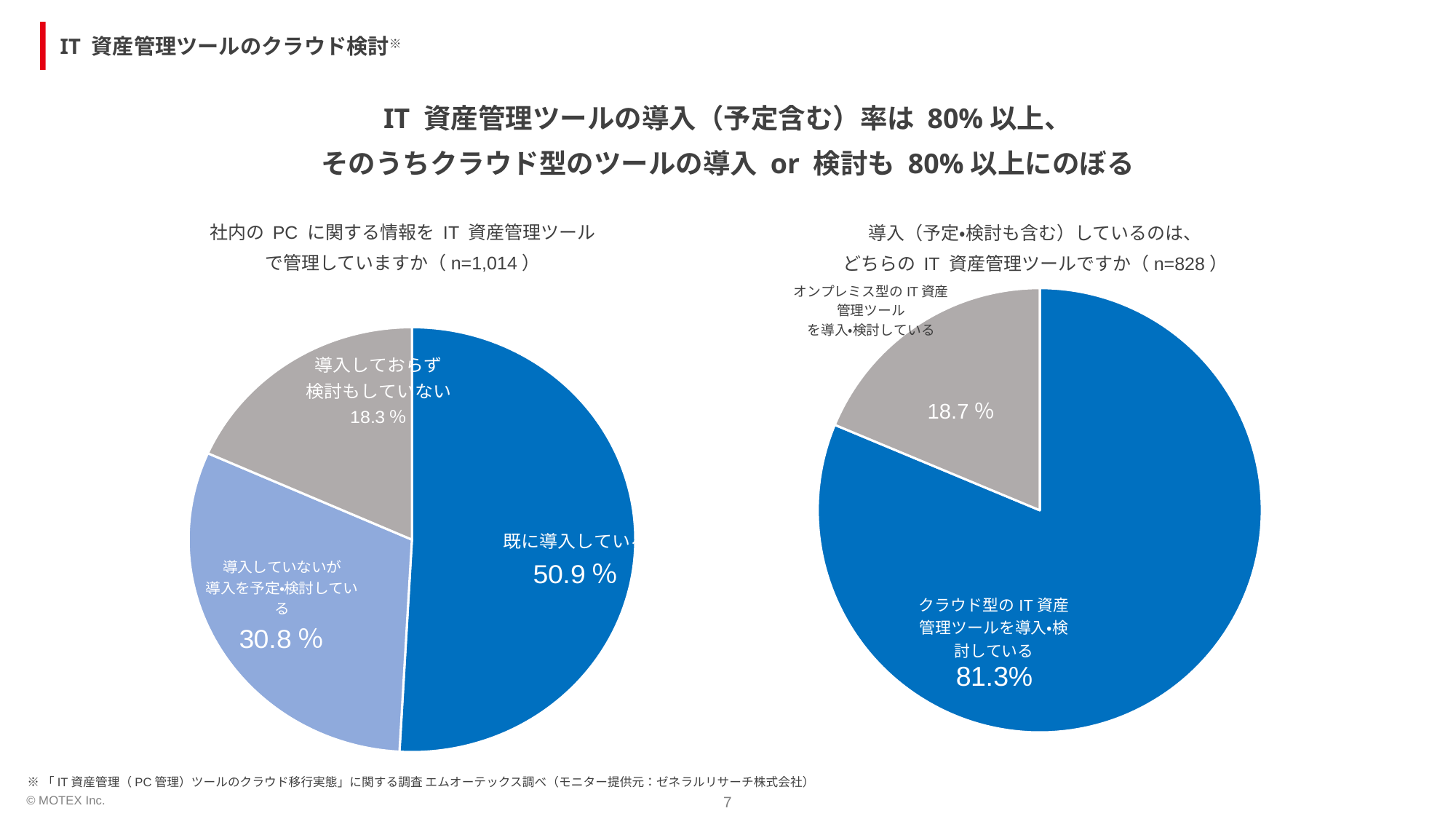
左の円グラフで、「既に導入している」と「導入していないが導入を予定・検討している」の割合の差はいくつですか？ 20.1% 右の円グラフには項目がいくつありますか？ 2 左の円グラフ（社内のPCに関する情報をIT資産管理ツールで管理していますか）で、「既に導入している」の割合はいくつですか？ 50.9% 右の円グラフで、「オンプレミス型のIT資産管理ツールを導入・検討している」の割合はいくつですか？ 18.7% 左の円グラフには項目がいくつありますか？ 3 左の円グラフで、「導入していないが導入を予定・検討している」の割合はいくつですか？ 30.8% 左の円グラフで、最も割合が小さい項目はどれですか？ 導入しておらず検討もしていない 右の円グラフ（導入しているのはどちらのIT資産管理ツールですか）で、「クラウド型のIT資産管理ツールを導入・検討している」の割合はいくつですか？ 81.3% このスライドのグラフはどの種類のグラフですか？ 円グラフ 左の円グラフで、「導入しておらず検討もしていない」の割合はいくつですか？ 18.3% 右の円グラフで、クラウド型とオンプレミス型の割合の差はいくつですか？ 62.6% 左の円グラフで、最も割合が大きい項目はどれですか？ 既に導入している